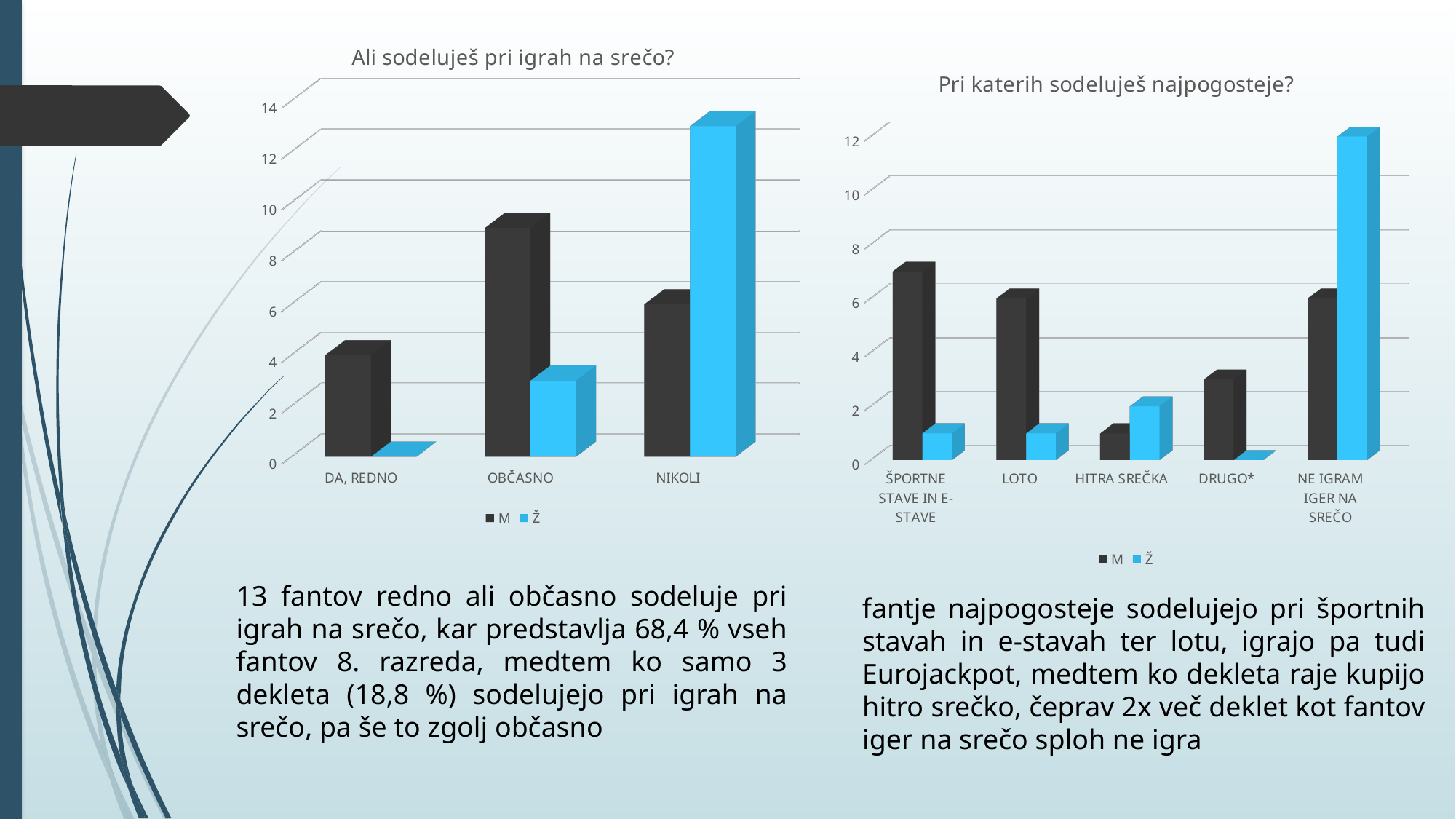
In the left chart "Ali sodeluješ pri igrah na srečo?", is the value for Ž in NIKOLI greater or less than 12? greater In the left chart "Ali sodeluješ pri igrah na srečo?", is the value for M in DA, REDNO greater or less than 6? less What kind of chart is the left chart titled "Ali sodeluješ pri igrah na srečo?"? bar chart What colour are the bars for the Ž series in the charts on the slide? light blue In the left chart "Ali sodeluješ pri igrah na srečo?", which category has the highest value for the Ž series? NIKOLI How many series does the legend of the left chart "Ali sodeluješ pri igrah na srečo?" list? 2 In the right chart "Pri katerih sodeluješ najpogosteje?", which is larger for HITRA SREČKA: the M value or the Ž value? Ž In the right chart "Pri katerih sodeluješ najpogosteje?", which category has the highest value for the Ž series? NE IGRAM IGER NA SREČO In the right chart "Pri katerih sodeluješ najpogosteje?", which category has the lowest value for the M series? HITRA SREČKA In the right chart "Pri katerih sodeluješ najpogosteje?", is the value for M in ŠPORTNE STAVE IN E-STAVE greater or less than 4? greater How many categories are shown on the x axis of the right chart titled "Pri katerih sodeluješ najpogosteje?"? 5 In the left chart "Ali sodeluješ pri igrah na srečo?", which category has the highest value for the M series? OBČASNO